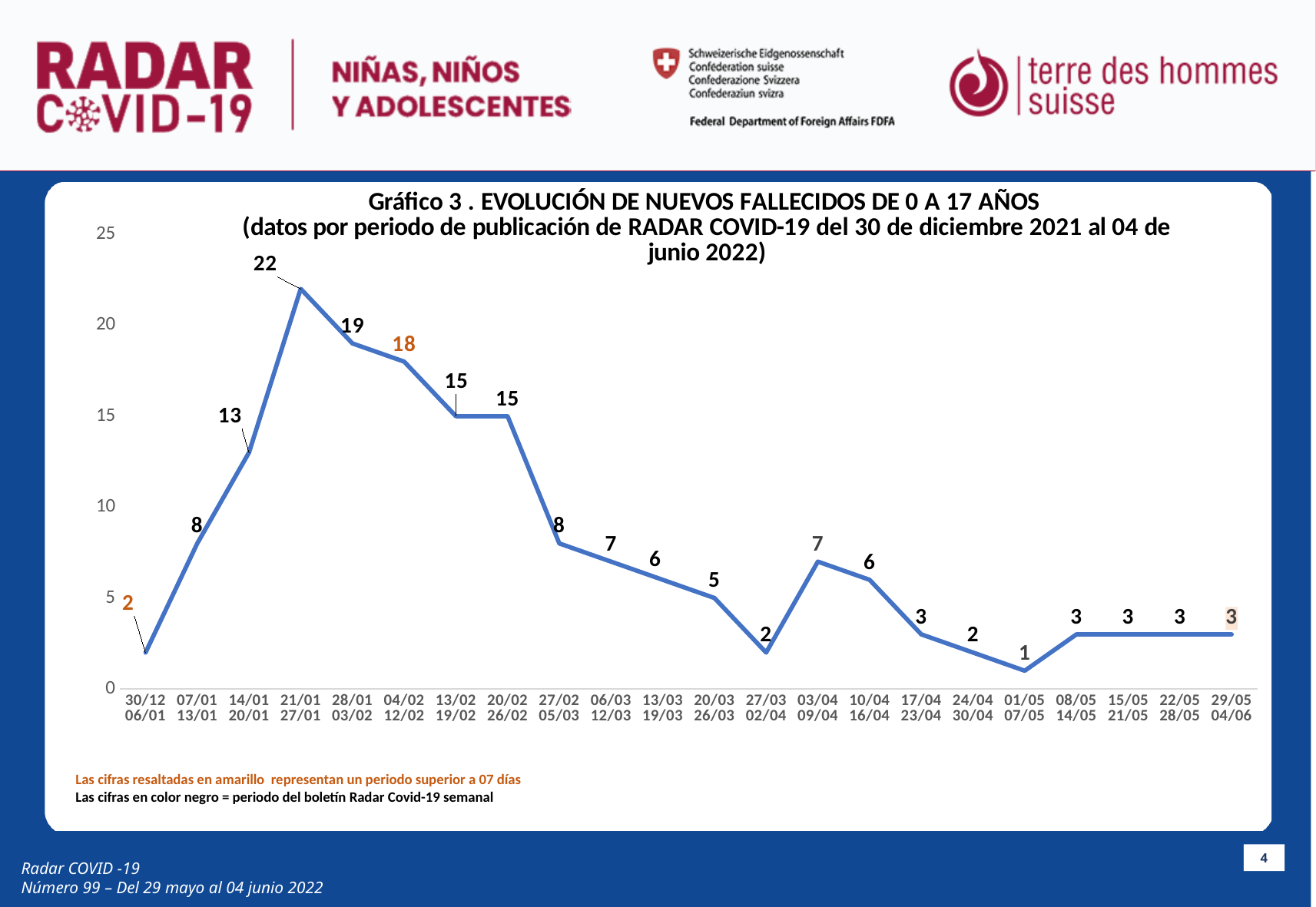
What is the value for the period 21/01–27/01? 22 Which period has the lowest value? 01/05–07/05 What is the number of the chart given in its title? Gráfico 3 What type of chart is shown on the slide? Line chart Which is larger, the value for 14/01–20/01 or the value for 13/02–19/02? 13/02–19/02 What is the value for the period 03/04–09/04? 7 What is the value for the period 04/02–12/02? 18 Which period has the highest value? 21/01–27/01 How many data points are plotted on the line? 22 What is the value for the period 01/05–07/05? 1 Does the line rise or fall between 21/01–27/01 and 27/03–02/04? Fall What is the difference between the values for 21/01–27/01 and 28/01–03/02? 3